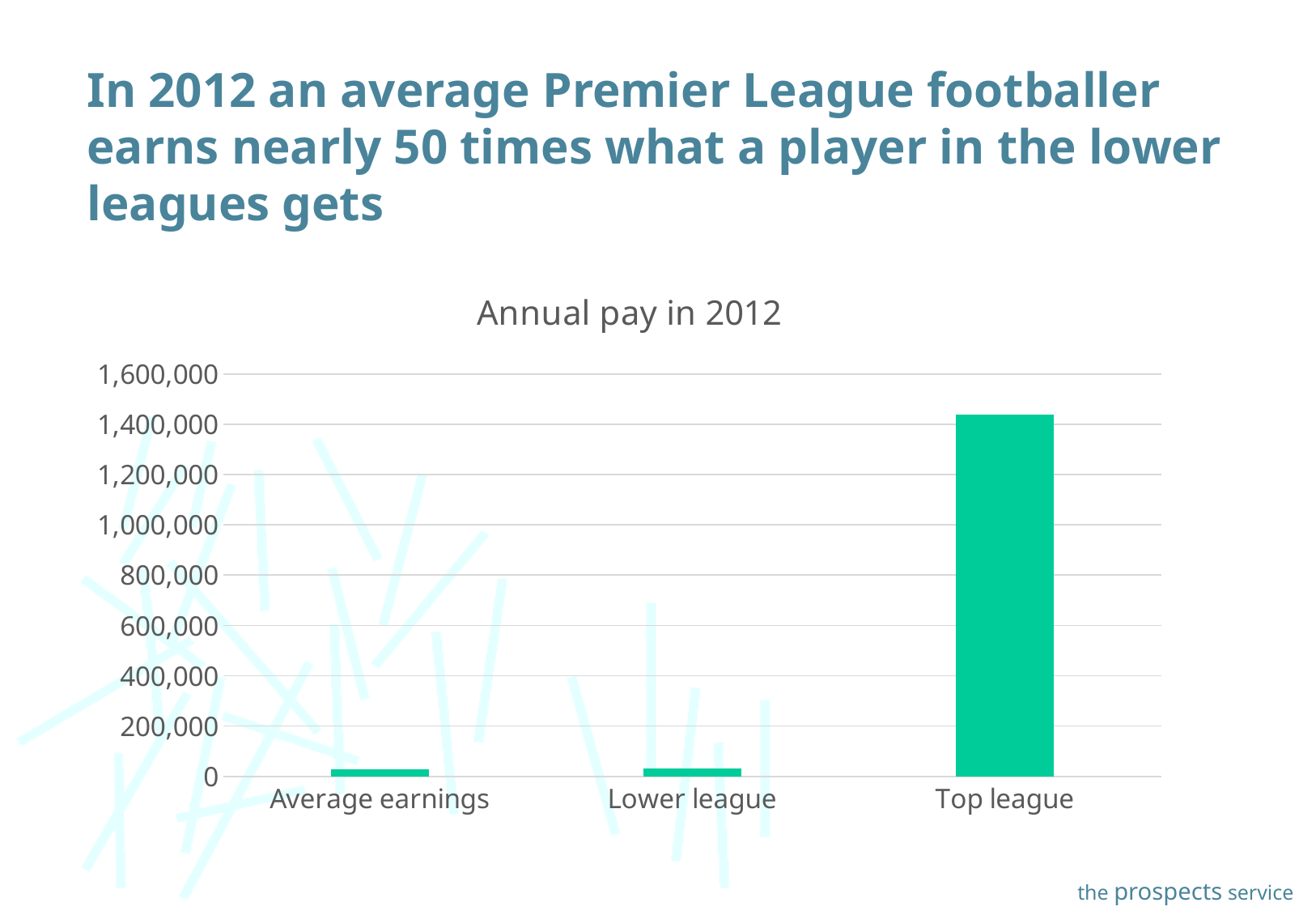
How many categories are shown on the x axis of the chart? 3 What kind of chart is shown on the slide? bar chart Is the value for Average earnings greater or less than 200,000? less Is the value for Top league greater or less than 1,200,000? greater Is the value for Top league greater or less than 1,600,000? less What is the highest value shown on the y axis of the chart? 1,600,000 What is the title of the chart? Annual pay in 2012 Which is larger, the value for Top league or the value for Average earnings? Top league Which category has the highest annual pay in the chart? Top league Which is larger, the value for Top league or the value for Lower league? Top league